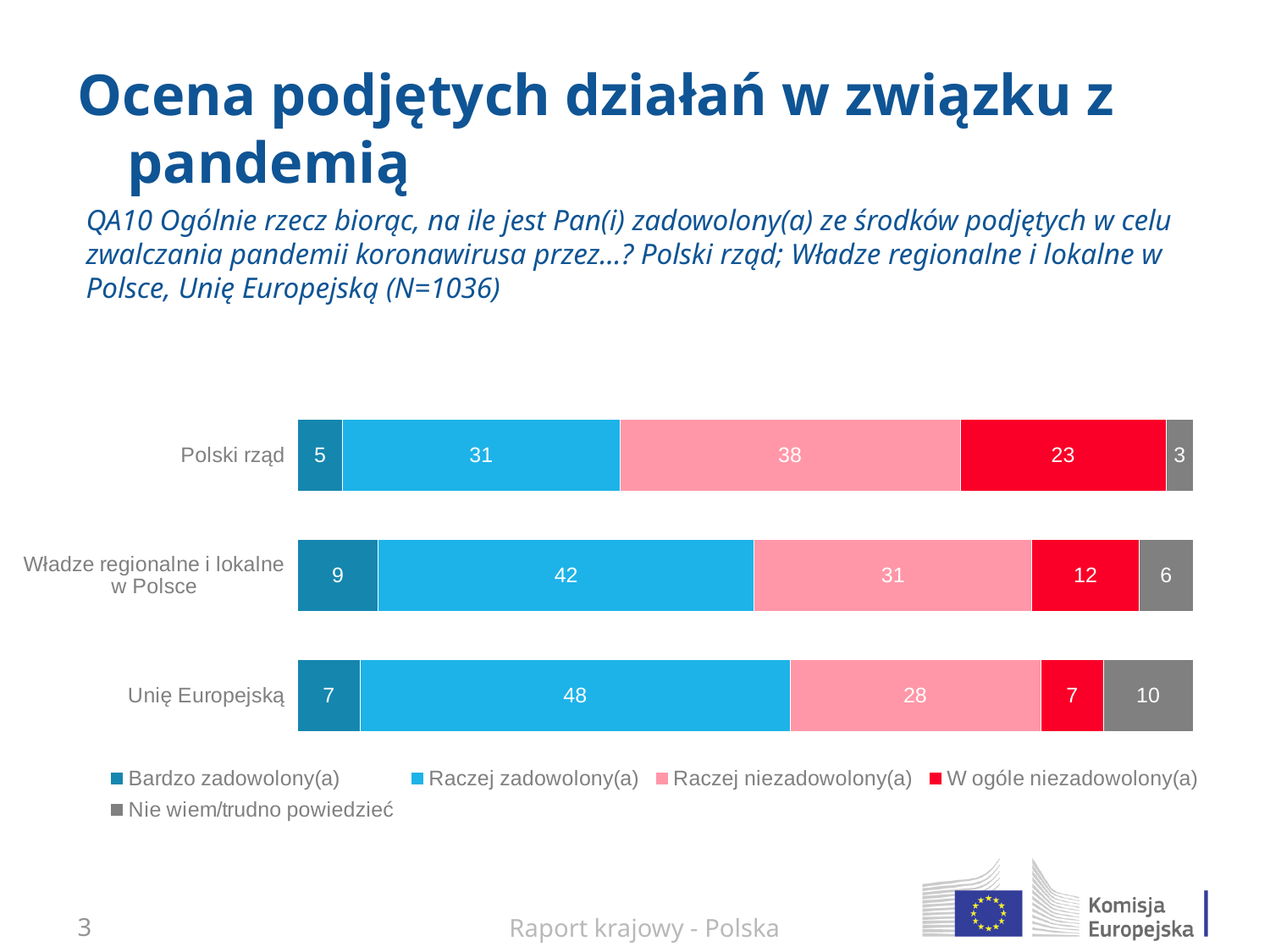
How many series does the legend list? 5 How many categories (bars) does the chart show? 3 What is the value for "W ogóle niezadowolony(a)" for Władze regionalne i lokalne w Polsce? 12 Which category has the lowest value for "Nie wiem/trudno powiedzieć"? Polski rząd What kind of chart is shown on the slide? Stacked bar chart Which is larger: the "Raczej zadowolony(a)" value for Polski rząd or for Władze regionalne i lokalne w Polsce? Władze regionalne i lokalne w Polsce What is the value for "Raczej niezadowolony(a)" for Polski rząd? 38 Which category has the highest value for "Bardzo zadowolony(a)"? Władze regionalne i lokalne w Polsce What is the total of the stacked bar for Unię Europejską? 100 Which legend entry is shown in red? W ogóle niezadowolony(a) What is the difference between the "W ogóle niezadowolony(a)" values for Polski rząd and Unię Europejską? 16 What is the value for "Raczej zadowolony(a)" for Unię Europejską? 48